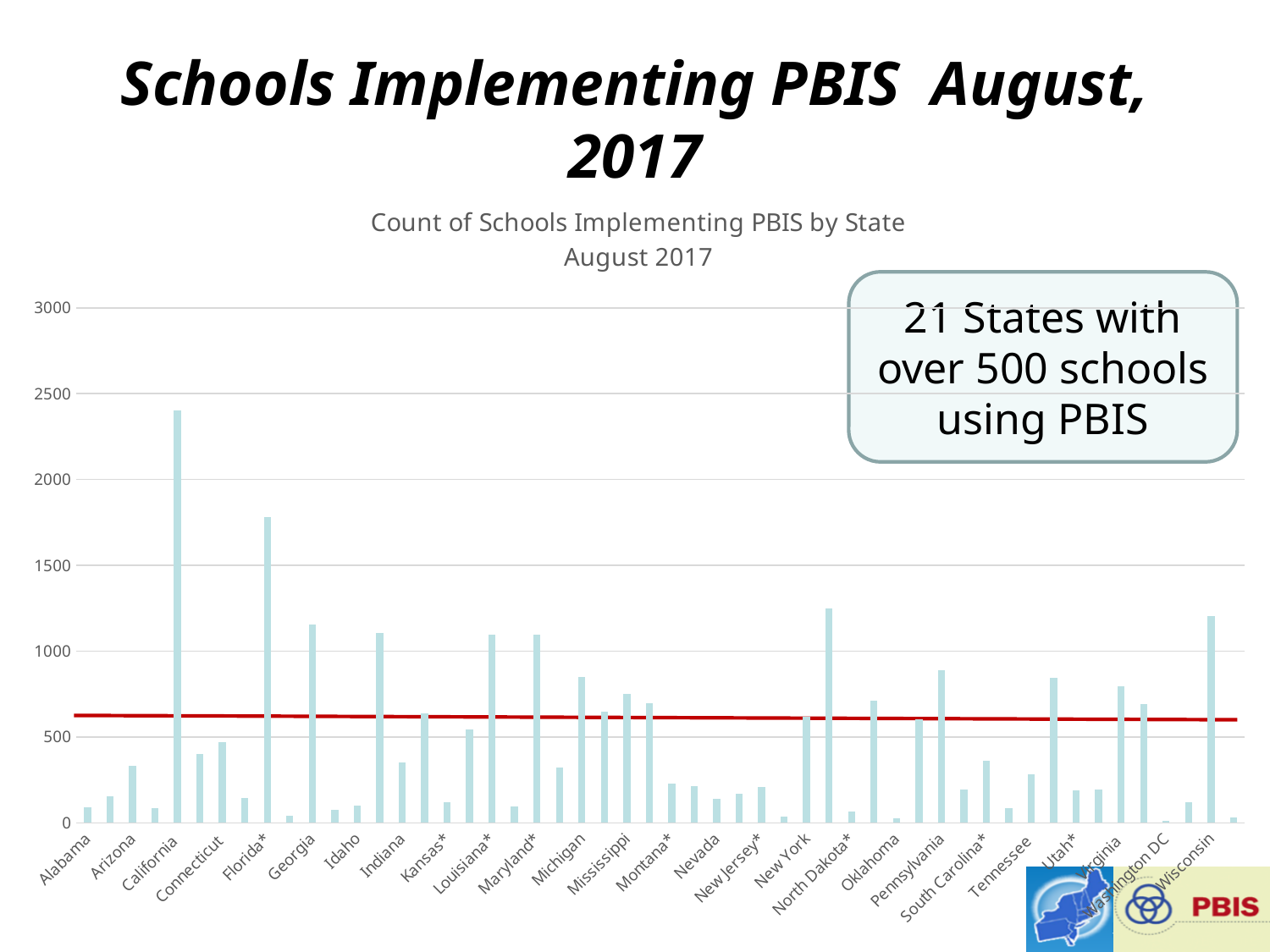
What is the title of the chart? Count of Schools Implementing PBIS by State August 2017 What kind of chart is shown on the slide? bar chart Is the value for Idaho greater or less than 500? less Is the value for Alabama greater or less than 500? less According to the callout box on the slide, how many states have over 500 schools using PBIS? 21 Is the value for North Dakota* greater or less than 1000? less Which state has the highest count of schools implementing PBIS? California Which has more schools implementing PBIS, Georgia or Nevada? Georgia Which has more schools implementing PBIS, California or Florida*? California